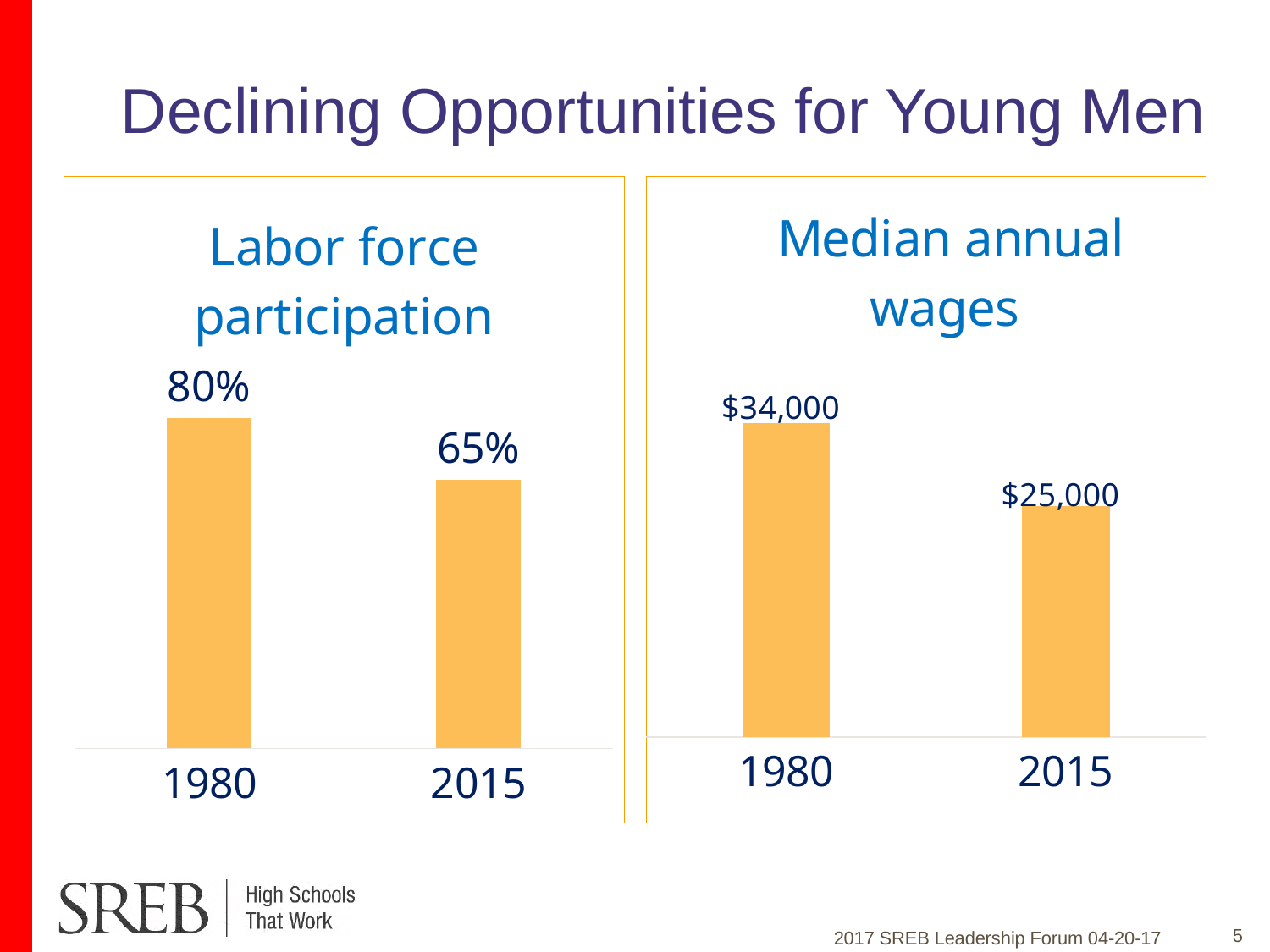
In the 'Labor force participation' chart, which year has the higher value? 1980 In the 'Median annual wages' chart, is the value for 1980 larger or smaller than the value for 2015? larger In the 'Labor force participation' chart, what is the value for 1980? 80% In the 'Labor force participation' chart, what is the value for 2015? 65% In the 'Median annual wages' chart, what is the value for 1980? $34,000 In the 'Median annual wages' chart, which year has the lower value? 2015 In the 'Median annual wages' chart, how much lower is the 2015 value than the 1980 value? $9,000 In the 'Labor force participation' chart, what is the difference between the 1980 and 2015 values? 15% In the 'Labor force participation' chart, do the values rise or fall from 1980 to 2015? fall How many bars are in the 'Labor force participation' chart? 2 In the 'Median annual wages' chart, what is the value for 2015? $25,000 What type of chart is the 'Median annual wages' chart? bar chart